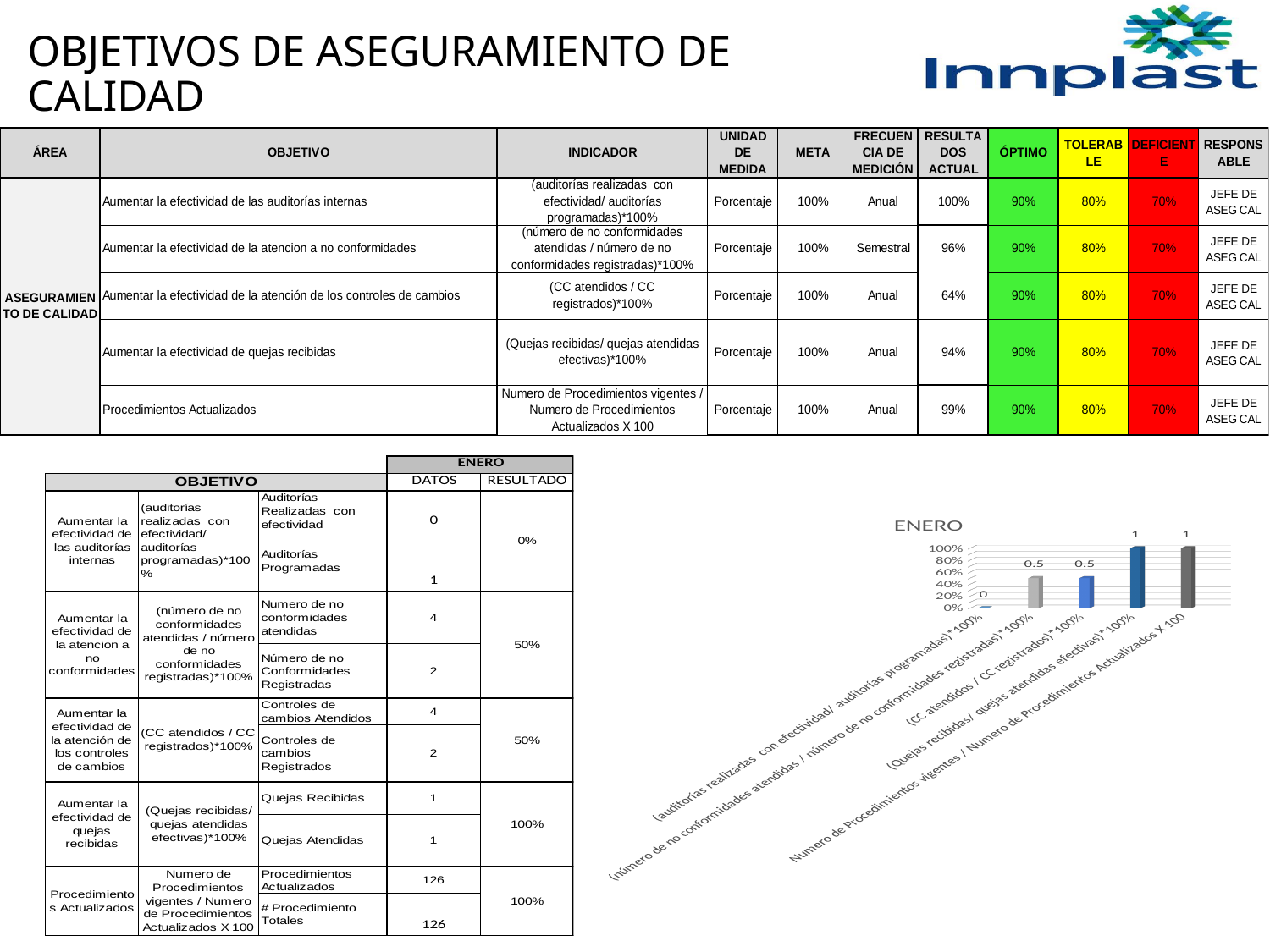
In the ENERO chart, is the bar for (Quejas recibidas/ quejas atendidas efectivas)*100% greater or less than 80%? greater What is the title of the chart on the slide? ENERO What kind of chart is shown on the slide? bar chart Which category has the lowest value in the ENERO chart? (auditorías realizadas con efectividad/ auditorías programadas)*100% Do the values in the ENERO chart generally rise or fall from left to right along the x axis? rise In the ENERO chart, what is the data label for Numero de Procedimientos vigentes / Numero de Procedimientos Actualizados X 100? 1 In the ENERO chart, what is the difference between the value for (Quejas recibidas/ quejas atendidas efectivas)*100% and the value for (número de no conformidades atendidas / número de no conformidades registradas)*100%? 0.5 How many categories are plotted in the ENERO chart? 5 In the ENERO chart, what is the data label for (CC atendidos / CC registrados)*100%? 0.5 In the ENERO chart, what is the data label for (auditorías realizadas con efectividad/ auditorías programadas)*100%? 0 In the ENERO chart, what is the data label for (Quejas recibidas/ quejas atendidas efectivas)*100%? 1 In the ENERO chart, which is larger: the value for (CC atendidos / CC registrados)*100% or the value for (Quejas recibidas/ quejas atendidas efectivas)*100%? (Quejas recibidas/ quejas atendidas efectivas)*100%